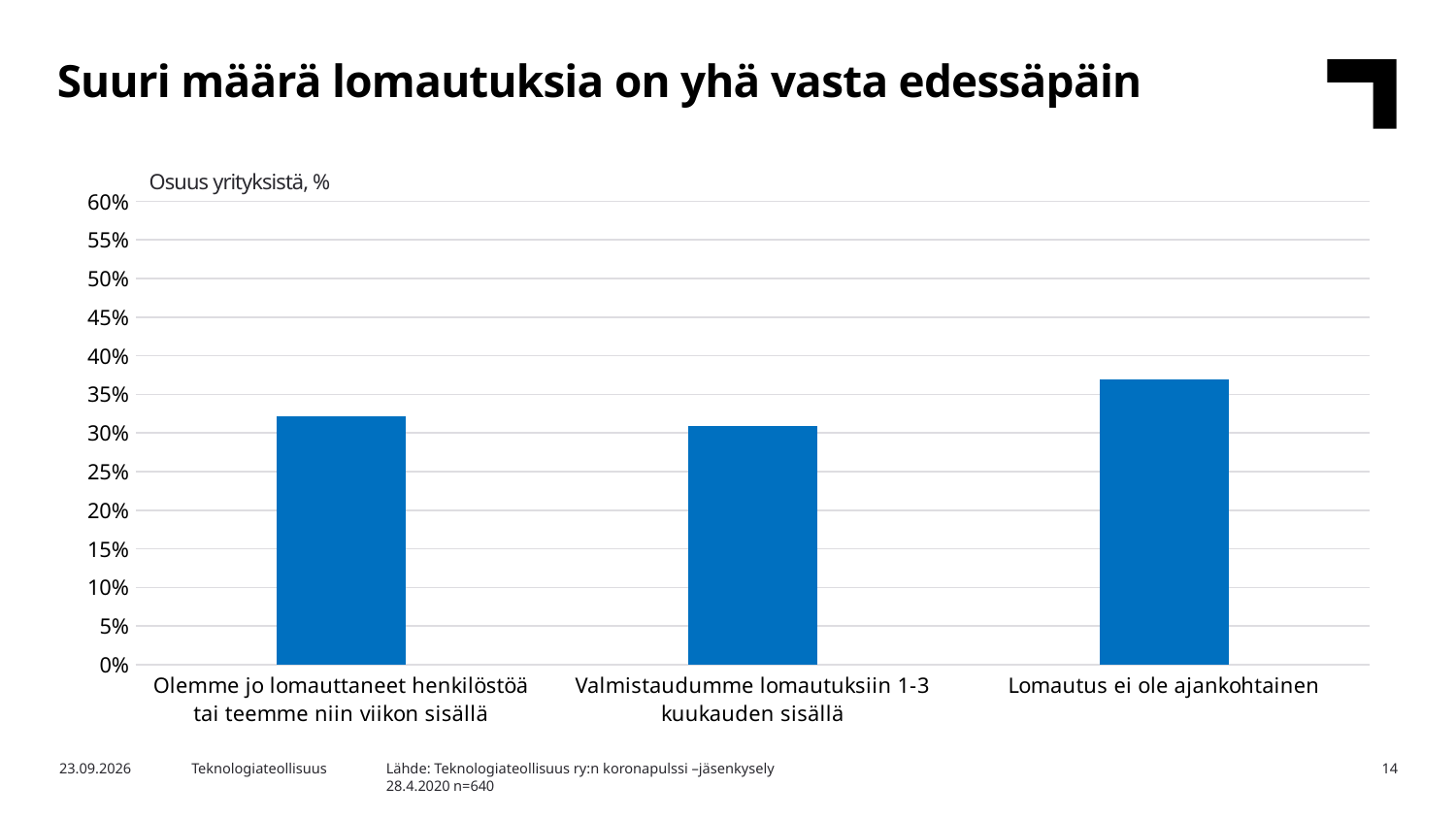
Is the value for 'Valmistaudumme lomautuksiin 1-3 kuukauden sisällä' greater or less than 25%? greater What kind of chart is shown on the slide? bar chart Is the value for 'Valmistaudumme lomautuksiin 1-3 kuukauden sisällä' greater or less than 35%? less What label is shown above the vertical axis of the chart? Osuus yrityksistä, % Is the value for 'Olemme jo lomauttaneet henkilöstöä tai teemme niin viikon sisällä' greater or less than 35%? less How many categories (bars) does the chart show? 3 Which category has the highest value? Lomautus ei ole ajankohtainen What is the title of the slide? Suuri määrä lomautuksia on yhä vasta edessäpäin Which is larger: the value for 'Lomautus ei ole ajankohtainen' or the value for 'Valmistaudumme lomautuksiin 1-3 kuukauden sisällä'? Lomautus ei ole ajankohtainen